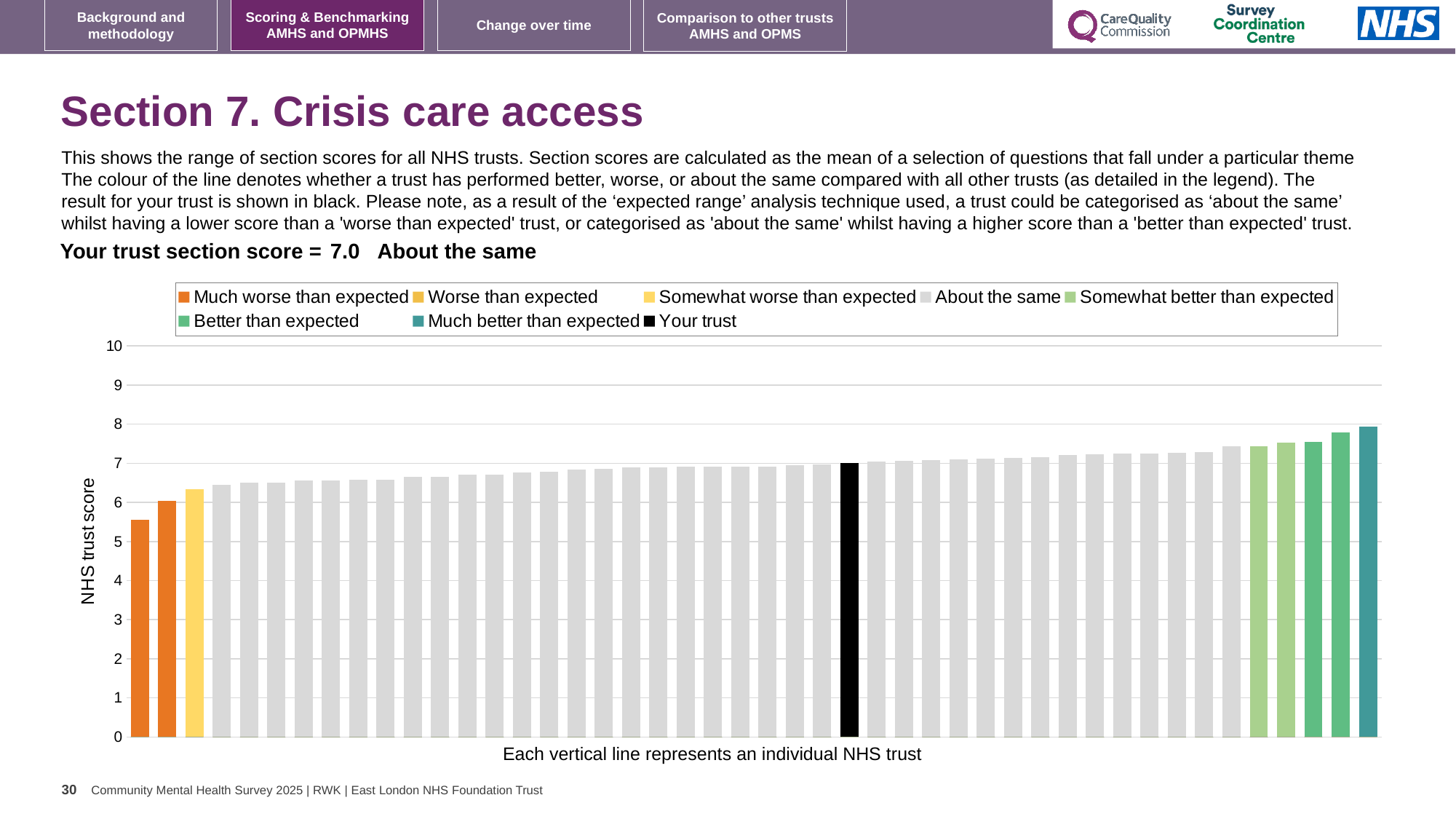
What is the section score for your trust shown on the slide? 7.0 Is the value of the leftmost (lowest) bar greater or less than 6? less Is the value of the black 'Your trust' bar greater or less than 6? greater Which legend category does the shortest bar belong to? Much worse than expected What is the label on the vertical axis of the chart? NHS trust score How many bars are coloured as 'Much worse than expected' (orange)? 2 How many entries does the chart legend list? 8 Do the bar values rise or fall from left to right along the x axis? Rise Which category is your trust placed in for crisis care access? About the same What kind of chart is shown on the slide? Bar chart Is the value of the rightmost (highest) bar greater or less than 7? greater Which legend category does the tallest bar belong to? Much better than expected